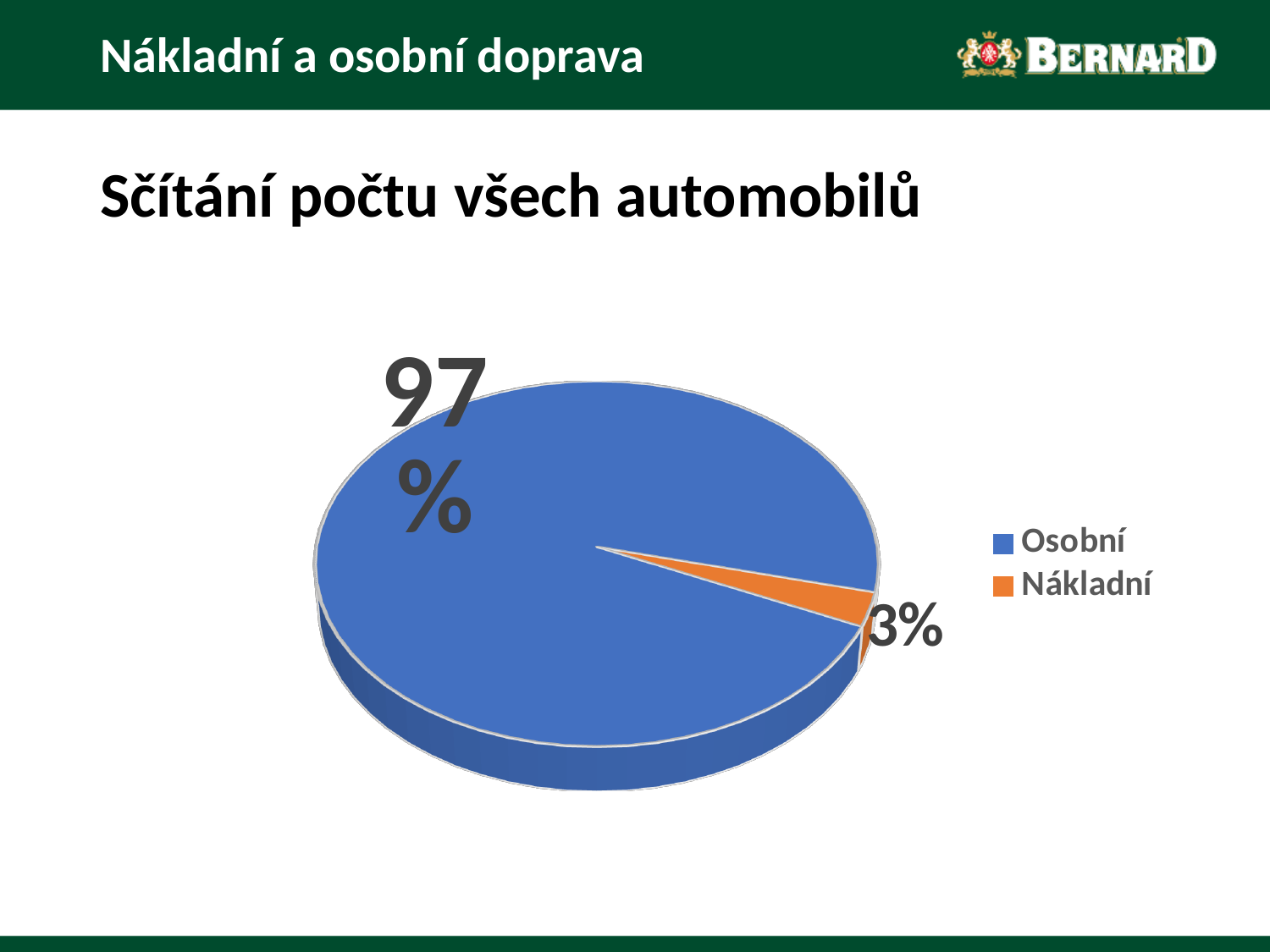
Which category has the smallest slice of the pie? Nákladní How many entries does the legend list? 2 What share of the pie does Nákladní represent? 3% Which category has the largest slice of the pie? Osobní What is the heading above the chart? Sčítání počtu všech automobilů What is the difference in percentage points between the Osobní and Nákladní slices? 94 What share of the pie does Osobní represent? 97% What kind of chart is shown on the slide? Pie chart Which is larger, the Osobní slice or the Nákladní slice? Osobní What colour is the Nákladní slice? Orange How many categories are shown in the pie chart? 2